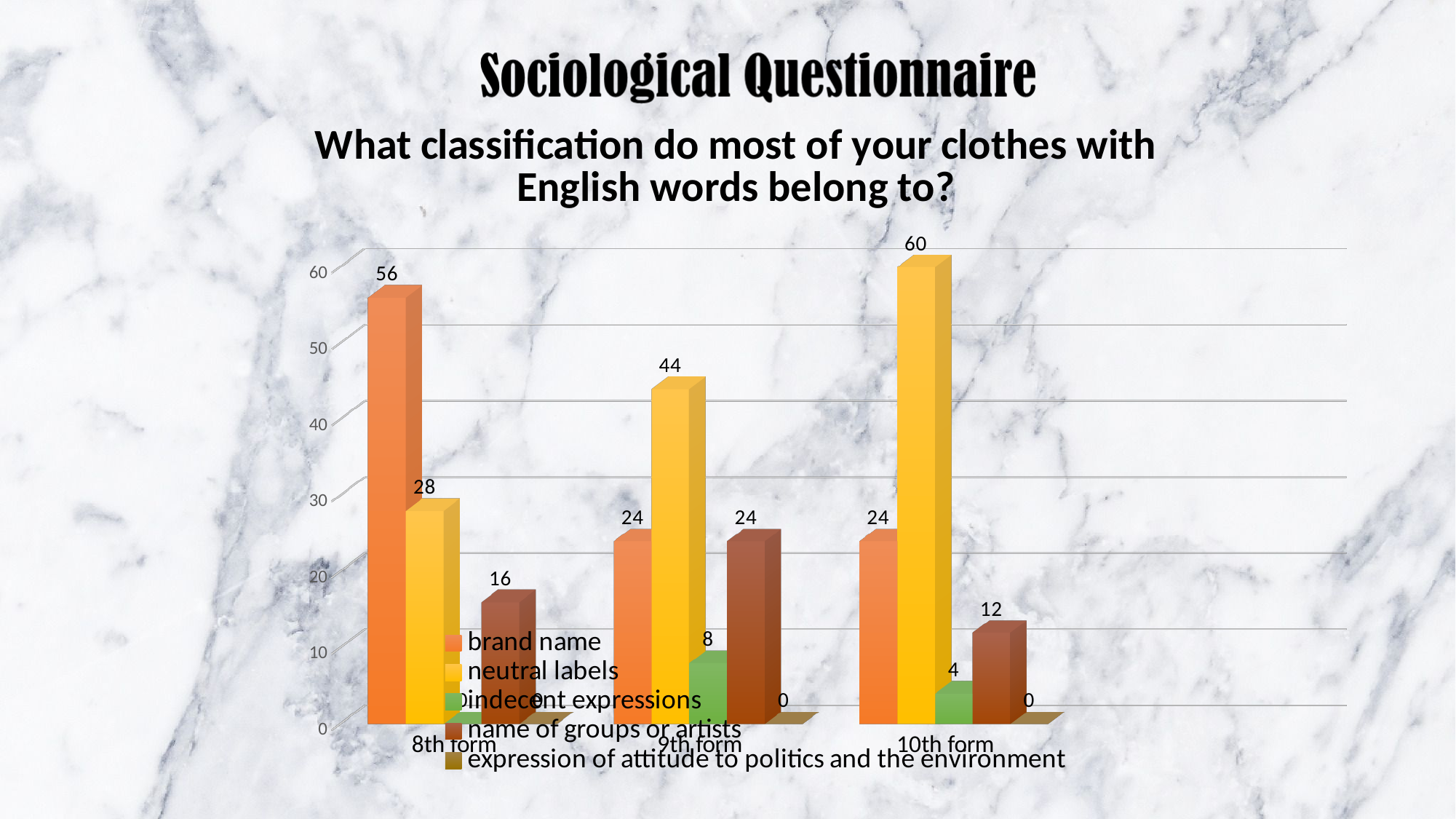
What is the difference between brand name in the 8th form and brand name in the 9th form? 32 Which form has the lowest value for name of groups or artists? 10th form What is the value for name of groups or artists in the 9th form? 24 What kind of chart is shown on the slide? bar chart What is the value for neutral labels in the 10th form? 60 What is the value for indecent expressions in the 10th form? 4 What is the value for brand name in the 8th form? 56 How many series does the legend list? 5 How many forms (categories) are shown on the x axis? 3 Do the values for neutral labels rise or fall from the 8th form to the 10th form? rise Which is larger in the 9th form: neutral labels or brand name? neutral labels Which form has the highest value for neutral labels? 10th form